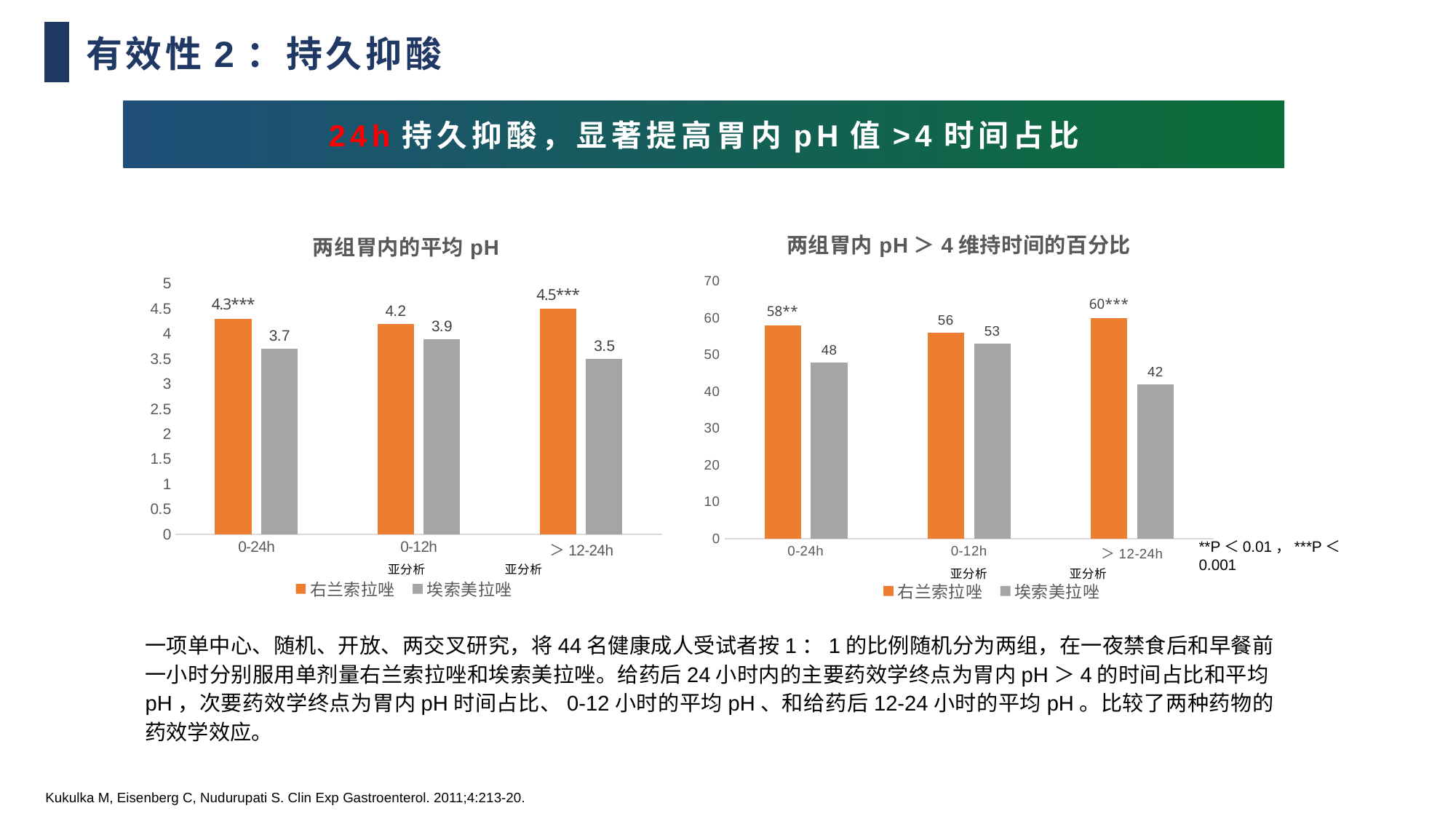
In the chart titled 两组胃内 pH ＞ 4 维持时间的百分比, what is the value for 右兰索拉唑 at ＞12-24h? 60 In the chart titled 两组胃内 pH ＞ 4 维持时间的百分比, which category has the lowest value for 埃索美拉唑? ＞12-24h In the chart titled 两组胃内的平均 pH, what is the difference between 右兰索拉唑 and 埃索美拉唑 at ＞12-24h? 1.0 In the chart titled 两组胃内的平均 pH, what is the value for 埃索美拉唑 at 0-12h? 3.9 In the chart titled 两组胃内的平均 pH, which category has the highest value for 右兰索拉唑? ＞12-24h In the chart titled 两组胃内 pH ＞ 4 维持时间的百分比, what is the value for 埃索美拉唑 at 0-24h? 48 In the chart titled 两组胃内 pH ＞ 4 维持时间的百分比, which is larger at 0-24h, 右兰索拉唑 or 埃索美拉唑? 右兰索拉唑 In the chart titled 两组胃内的平均 pH, what is the value for 右兰索拉唑 at 0-24h? 4.3 In the chart titled 两组胃内的平均 pH, how many series does the legend list? 2 In the chart titled 两组胃内 pH ＞ 4 维持时间的百分比, what is the difference between 右兰索拉唑 and 埃索美拉唑 at 0-12h? 3 What kind of chart is the chart titled 两组胃内的平均 pH? bar chart In the chart titled 两组胃内 pH ＞ 4 维持时间的百分比, how many categories are shown on the x axis? 3